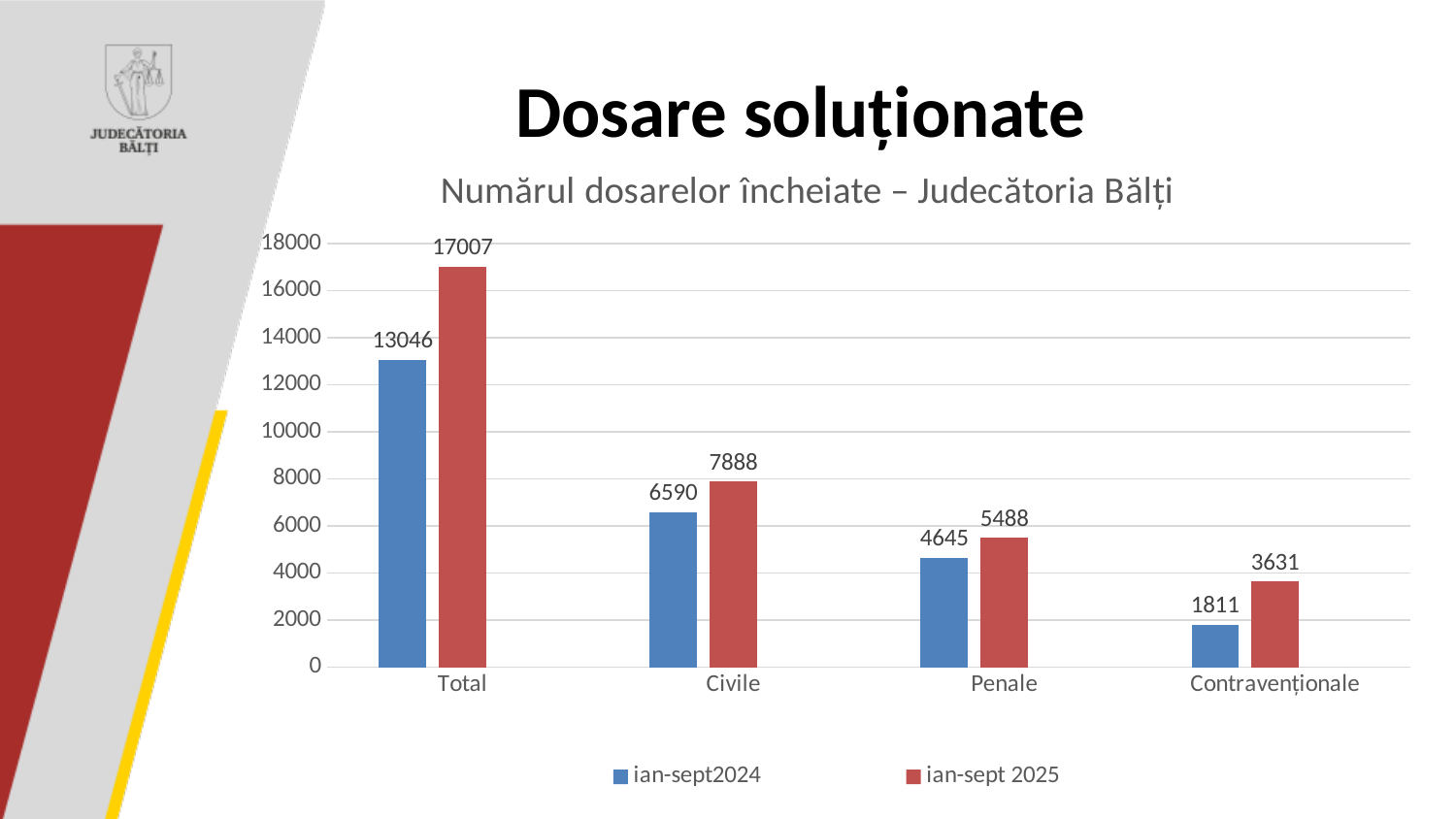
What kind of chart is shown on the slide? bar chart Is the value for Penale in the ian-sept 2025 series greater or less than 6000? less What is the difference between the ian-sept 2025 and ian-sept2024 values for Total? 3961 How many categories are shown on the x axis? 4 What is the value for Total in the ian-sept 2025 series? 17007 How many series does the legend list? 2 What is the value for Civile in the ian-sept2024 series? 6590 Which category has the lowest value in the ian-sept2024 series? Contravenționale What is the difference between the ian-sept 2025 and ian-sept2024 values for Penale? 843 What is the value for Contravenționale in the ian-sept 2025 series? 3631 Which category has the highest value in the ian-sept 2025 series? Total Which is larger for Civile: the ian-sept2024 value or the ian-sept 2025 value? ian-sept 2025